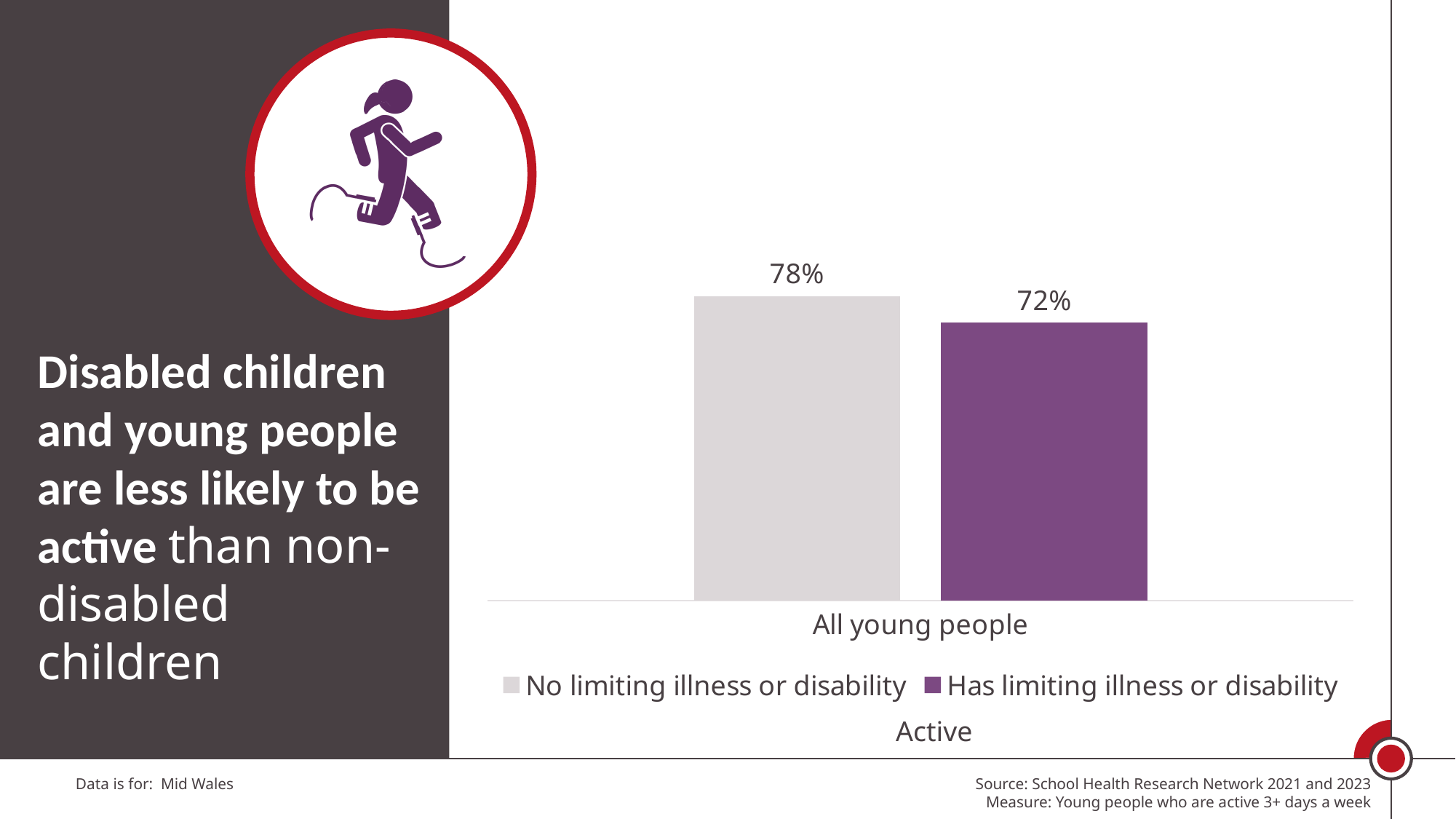
What is the value for 'Has limiting illness or disability' in the chart? 72% Which series has the higher value in the chart? No limiting illness or disability How many series does the legend list? 2 What is the difference between the 'No limiting illness or disability' and 'Has limiting illness or disability' values? 6% What is the title shown below the chart's legend? Active What is the value for 'No limiting illness or disability' in the chart? 78% What is the category label on the x axis of the chart? All young people How many categories are shown on the x axis of the chart? 1 What kind of chart is shown on the slide? bar chart Which series has the lower value in the chart? Has limiting illness or disability Is the value for 'No limiting illness or disability' larger or smaller than the value for 'Has limiting illness or disability'? larger